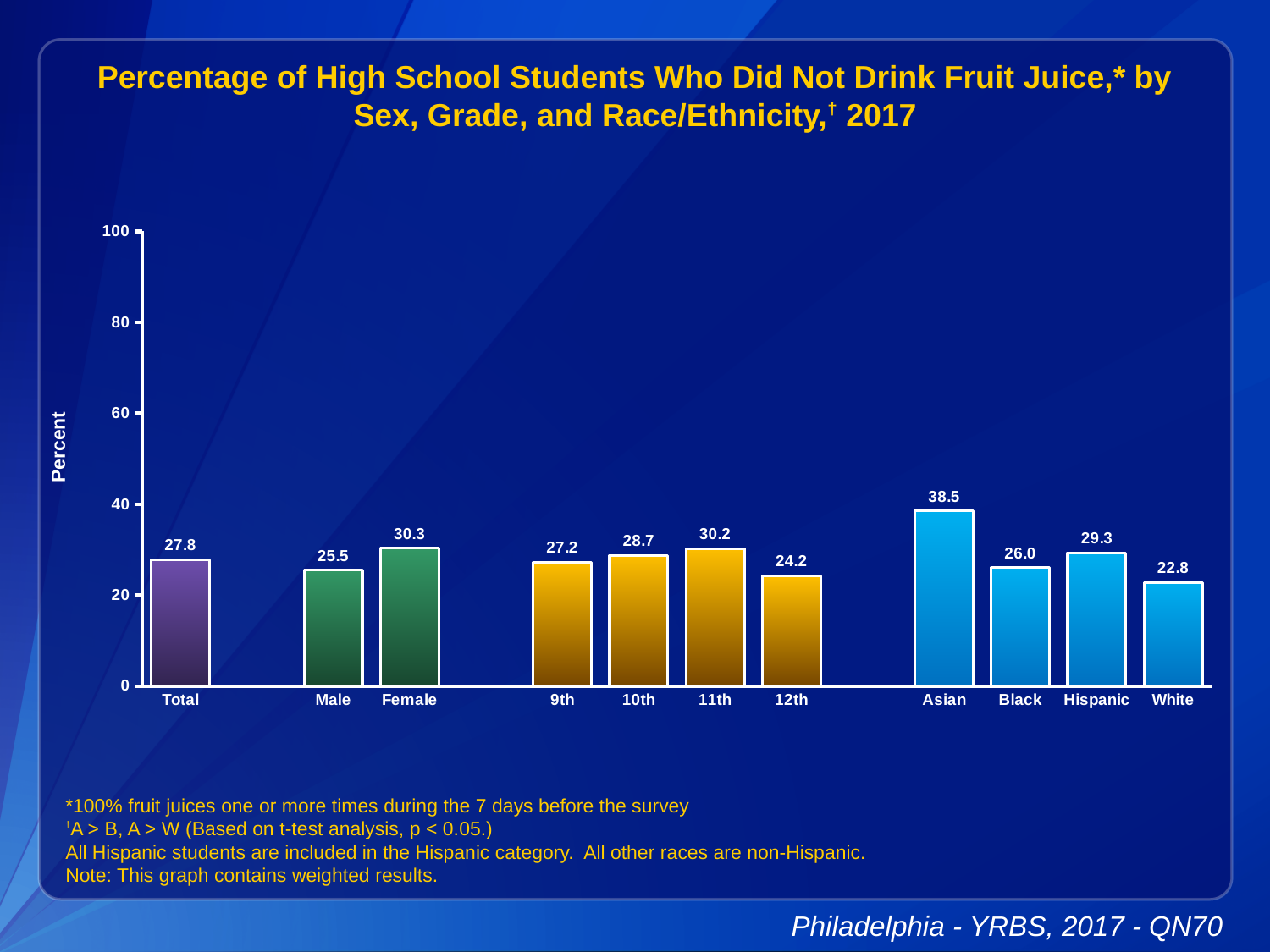
How many categories are shown on the x axis? 11 What is the difference between the values for Female and Male? 4.8 What is the value for Female? 30.3 What is the difference between the values for Asian and White? 15.7 Which is larger, the value for 11th grade or 12th grade? 11th Is the value for Asian greater or less than 40? less Which category has the highest value? Asian What is the value for 12th grade? 24.2 Which category has the lowest value? White What is the value for Total? 27.8 What kind of chart is this? bar chart What is the label of the y axis? Percent